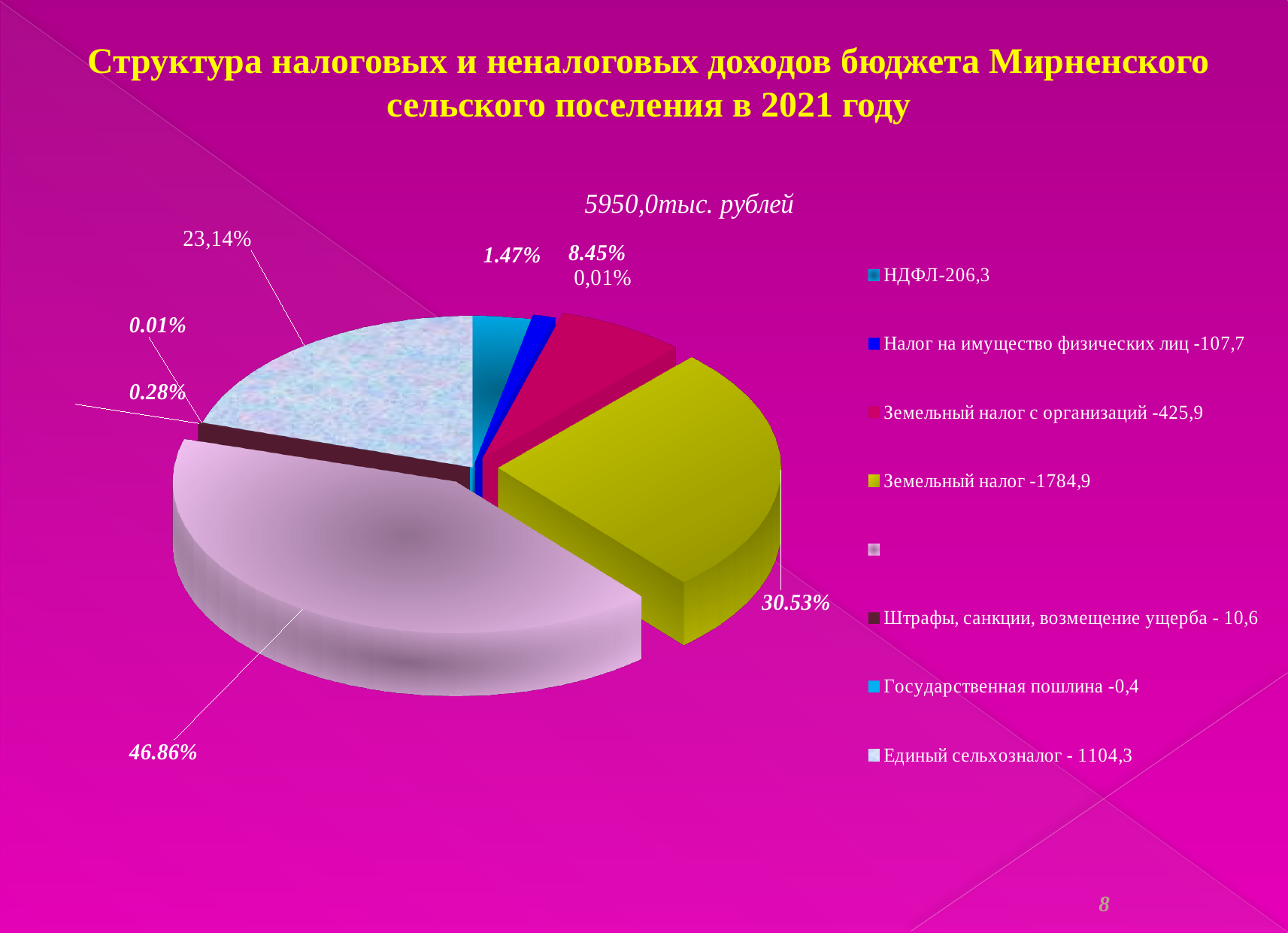
What is the total amount shown above the pie chart? 5950,0тыс. рублей Which labelled legend category has the largest value? Земельный налог What kind of chart is shown on the slide? pie chart What value does the legend give for Земельный налог? 1784,9 Which labelled legend category has the smallest value? Государственная пошлина What is the difference between the values for Земельный налог and Единый сельхозналог? 680,6 What percentage label is attached to the yellow slice of the pie? 30.53% What value does the legend give for Государственная пошлина? 0,4 What value does the legend give for Единый сельхозналог? 1104,3 Which is larger: the value for Земельный налог с организаций or the value for НДФЛ? Земельный налог с организаций What is the largest percentage label shown on the pie chart? 46.86% What value does the legend give for НДФЛ? 206,3